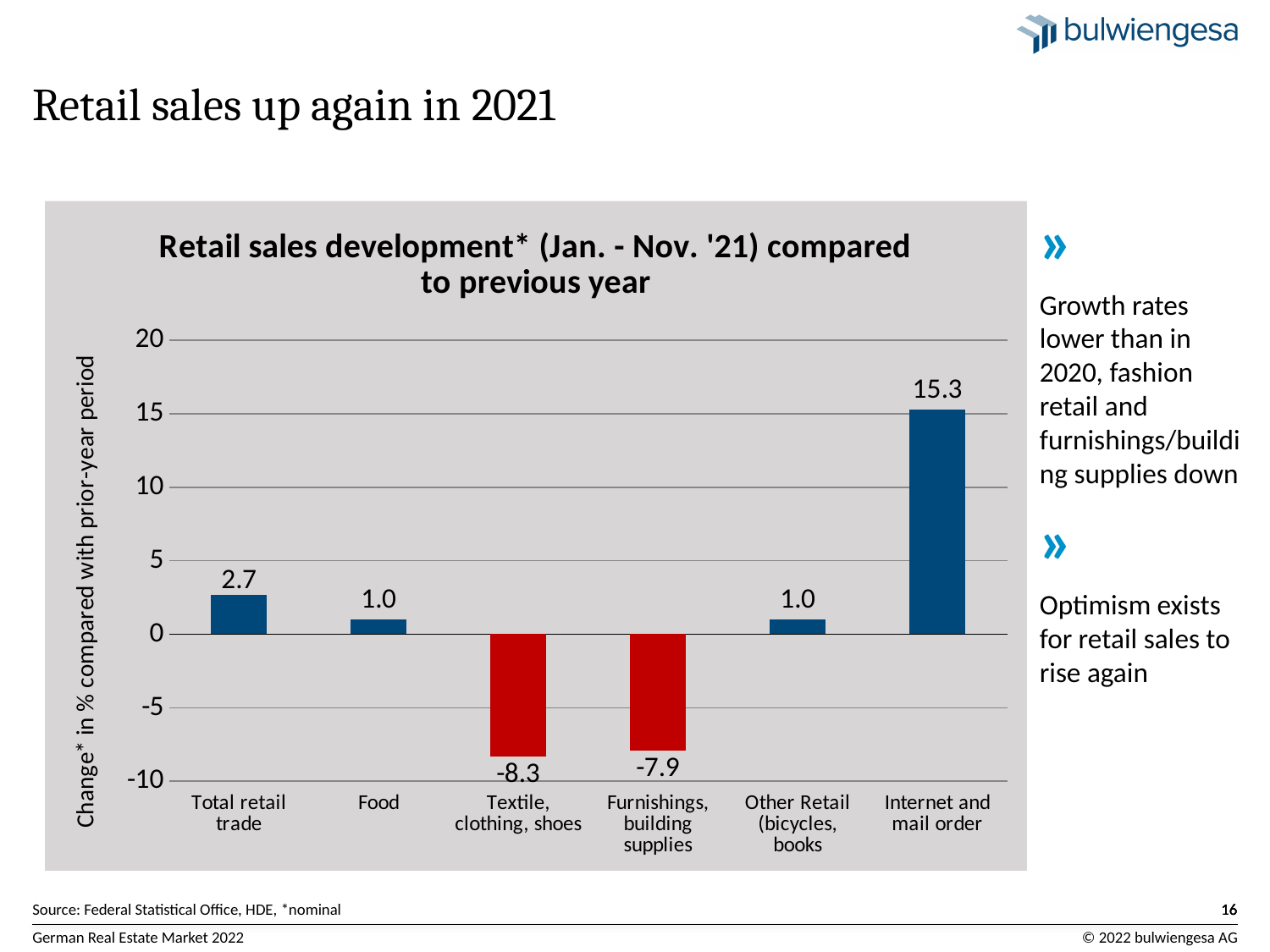
How many categories are shown in the chart? 6 What is the value for Total retail trade? 2.7 Is the value for Internet and mail order greater or less than 10? greater What is the value for Textile, clothing, shoes? -8.3 Which category has the highest value? Internet and mail order What is the value for Internet and mail order? 15.3 What is the title of the chart? Retail sales development* (Jan. - Nov. '21) compared to previous year Which is larger, the value for Total retail trade or the value for Food? Total retail trade What is the difference between the values for Internet and mail order and Total retail trade? 12.6 What is the value for Furnishings, building supplies? -7.9 What kind of chart is shown on the slide? bar chart Which category has the lowest value? Textile, clothing, shoes